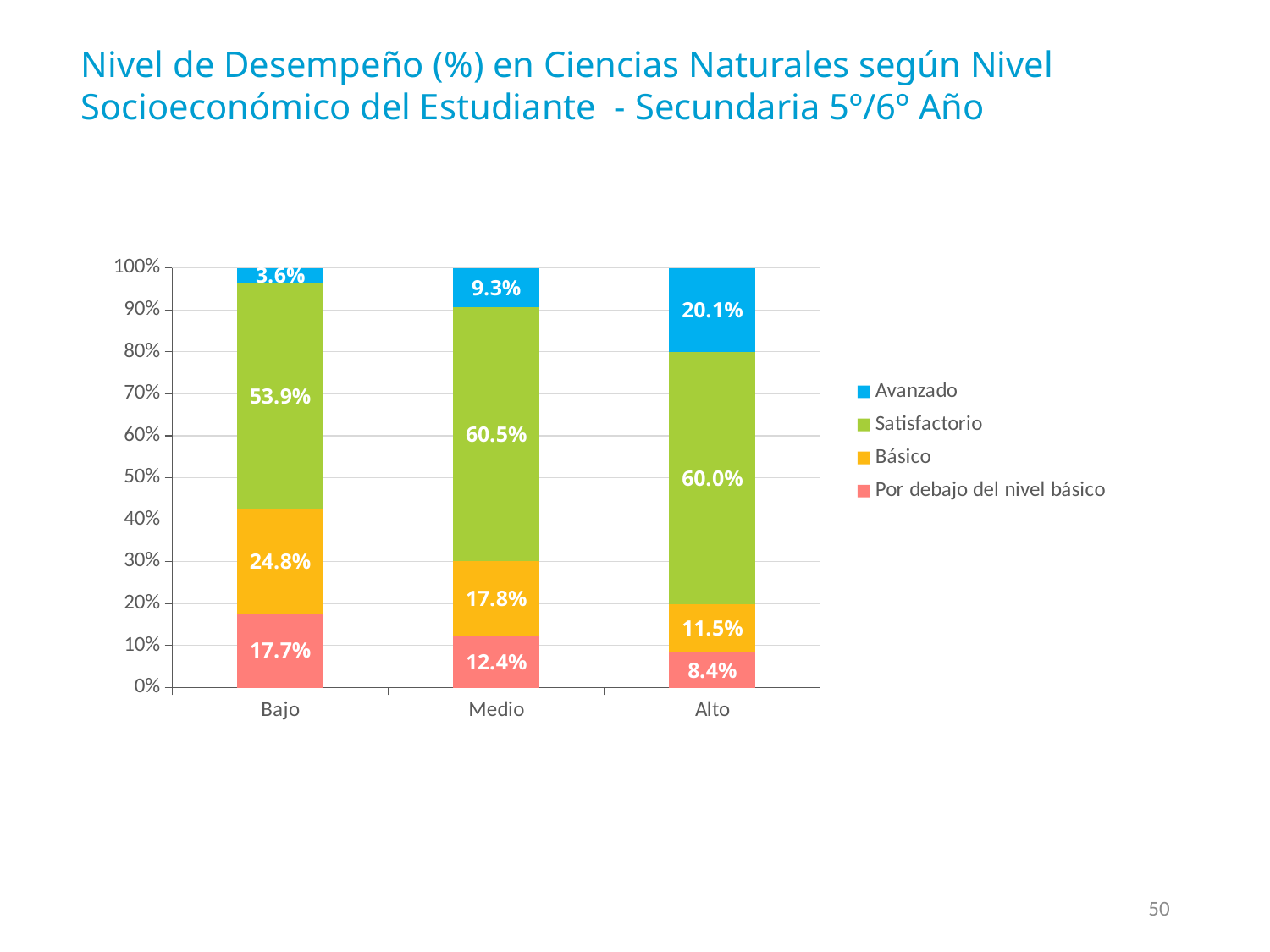
What is the Por debajo del nivel básico value for Bajo? 17.7% Which category has the highest Avanzado value? Alto Which is larger, the Avanzado value for Medio or the Avanzado value for Bajo? Medio What is the Básico value for Medio? 17.8% What is the Avanzado value for Alto? 20.1% What is the Satisfactorio value for Medio? 60.5% Which category has the lowest Por debajo del nivel básico value? Alto Do the Avanzado values rise or fall from Bajo to Alto? Rise What is the difference between the Básico values for Bajo and Alto? 13.3% How many categories are shown on the x axis? 3 What kind of chart is shown on the slide? Stacked bar chart How many series does the legend list? 4